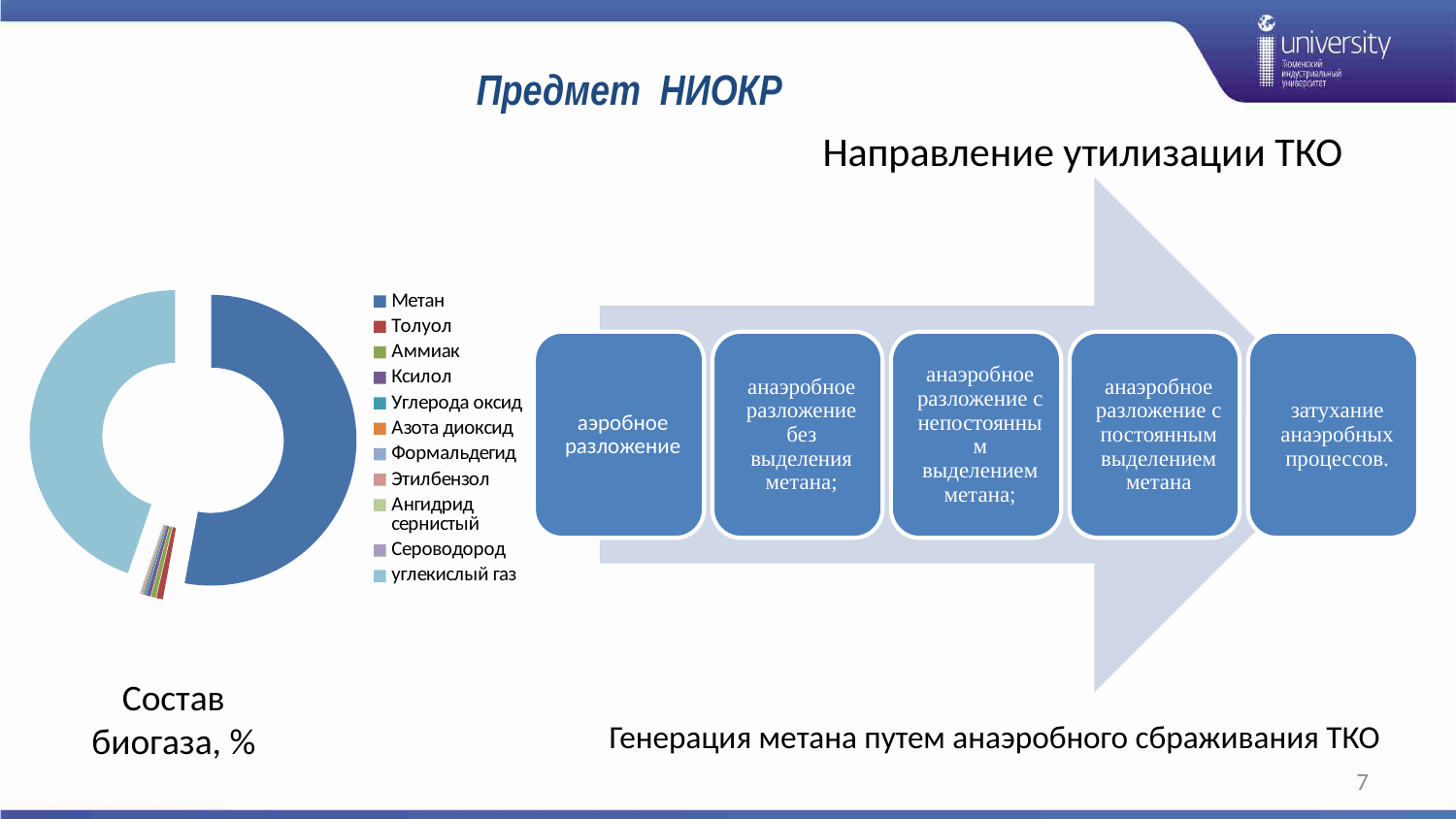
What kind of chart is shown on the slide under the heading "Состав биогаза, %"? doughnut (pie) chart In the biogas composition chart, which is larger: Метан or Толуол? Метан What is the caption/title given for the doughnut chart on the slide? Состав биогаза, % In the biogas composition chart, which is larger: углекислый газ or Аммиак? углекислый газ How many categories does the legend of the biogas composition chart list? 11 In the biogas composition chart, which is larger: Метан or Сероводород? Метан What colour represents Метан in the biogas composition chart? dark blue